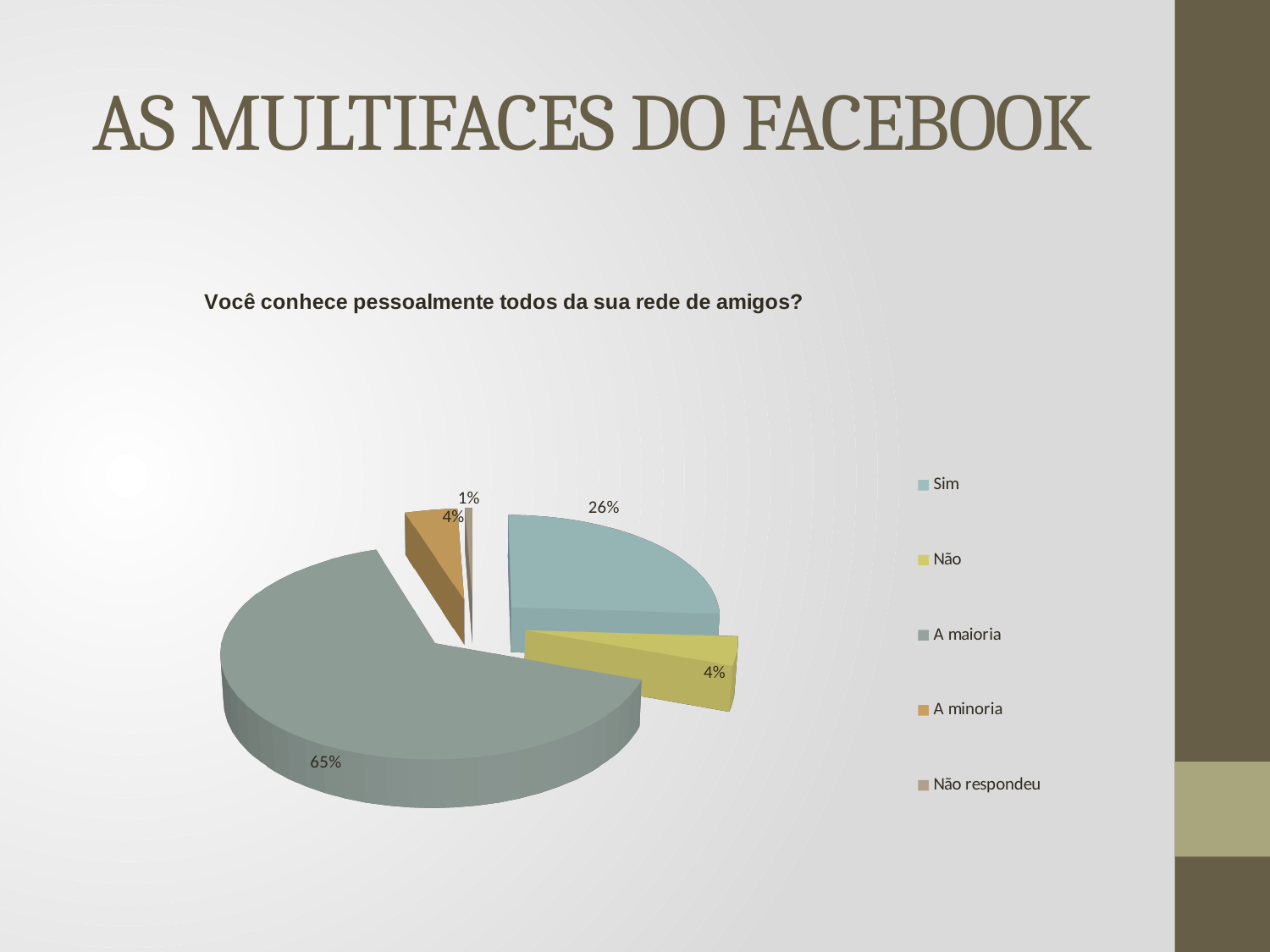
Which category has the smallest slice of the pie? Não respondeu What percentage of the pie does the "Sim" slice represent? 26% What percentage of the pie does the "Não" slice represent? 4% How many categories does the legend list? 5 Which is larger, the "Sim" slice or the "A minoria" slice? Sim What percentage of the pie does the "A maioria" slice represent? 65% What is the title of the chart? Você conhece pessoalmente todos da sua rede de amigos? Which category has the largest slice of the pie? A maioria What kind of chart is shown on the slide? pie chart Which legend entry is shown in yellow? Não What is the difference between the "A maioria" slice and the "Sim" slice? 39% What percentage of the pie does the "Não respondeu" slice represent? 1%